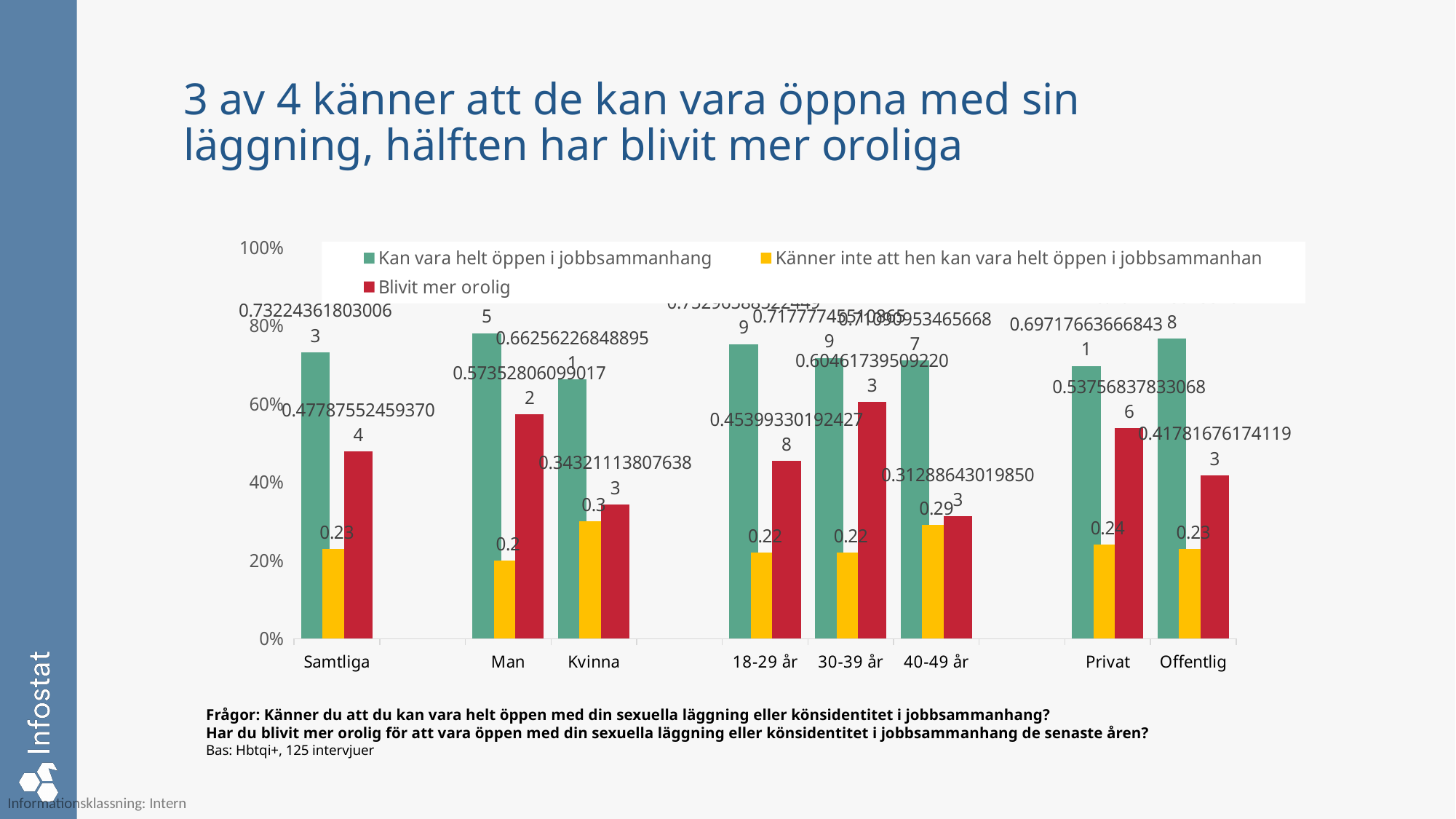
What is the value of 'Känner inte att hen kan vara helt öppen i jobbsammanhan' for 40-49 år? 0.29 Which has the larger 'Kan vara helt öppen i jobbsammanhang' value, Man or Kvinna? Man How many categories are shown along the x axis? 8 How many series does the legend list? 3 What kind of chart is shown on the slide? bar chart What is the difference between the 'Känner inte att hen kan vara helt öppen i jobbsammanhan' values for Kvinna and Man? 0.1 Is the 'Kan vara helt öppen i jobbsammanhang' value for Samtliga greater or less than 60%? greater What is the value of 'Känner inte att hen kan vara helt öppen i jobbsammanhan' for Kvinna? 0.3 What is the value of 'Känner inte att hen kan vara helt öppen i jobbsammanhan' for Man? 0.2 What is the value of 'Känner inte att hen kan vara helt öppen i jobbsammanhan' for Samtliga? 0.23 Is the 'Blivit mer orolig' value for 40-49 år greater or less than 40%? less Which colour represents 'Blivit mer orolig' in the legend? red